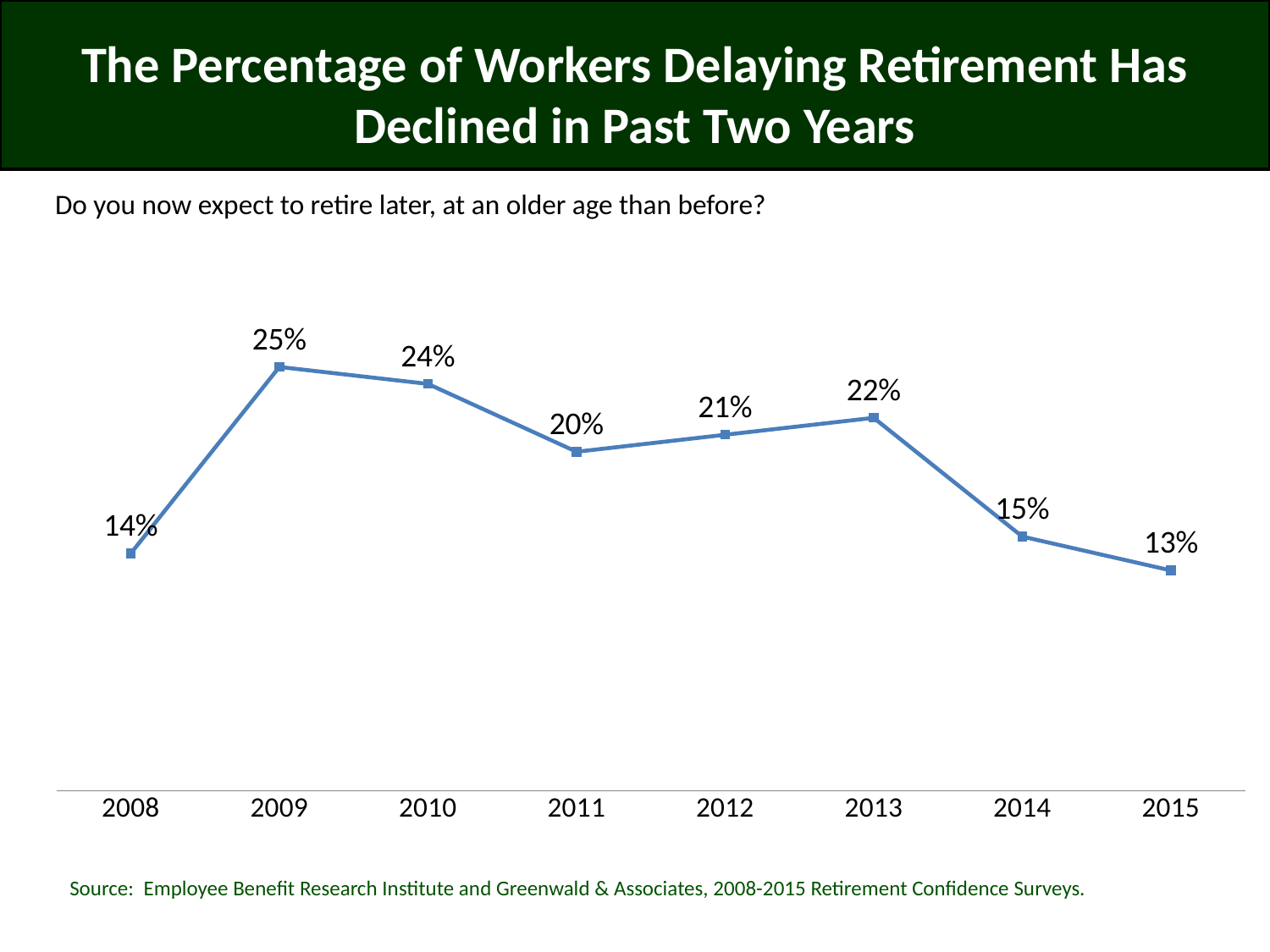
Which year has the highest percentage of workers expecting to retire later? 2009 What is the difference in percentage points between 2009 and 2015? 12 What kind of chart is shown on the slide? Line chart Which year has a higher value, 2010 or 2011? 2010 Do the values rise or fall from 2013 to 2015? Fall What percentage of workers expected to retire later in 2009? 25% Which year has the lowest percentage of workers expecting to retire later? 2015 What is the value shown for 2012? 21% How many years are plotted on the chart? 8 What is the difference in percentage points between 2013 and 2014? 7 What survey question is the chart based on? Do you now expect to retire later, at an older age than before? What is the value shown for 2015? 13%